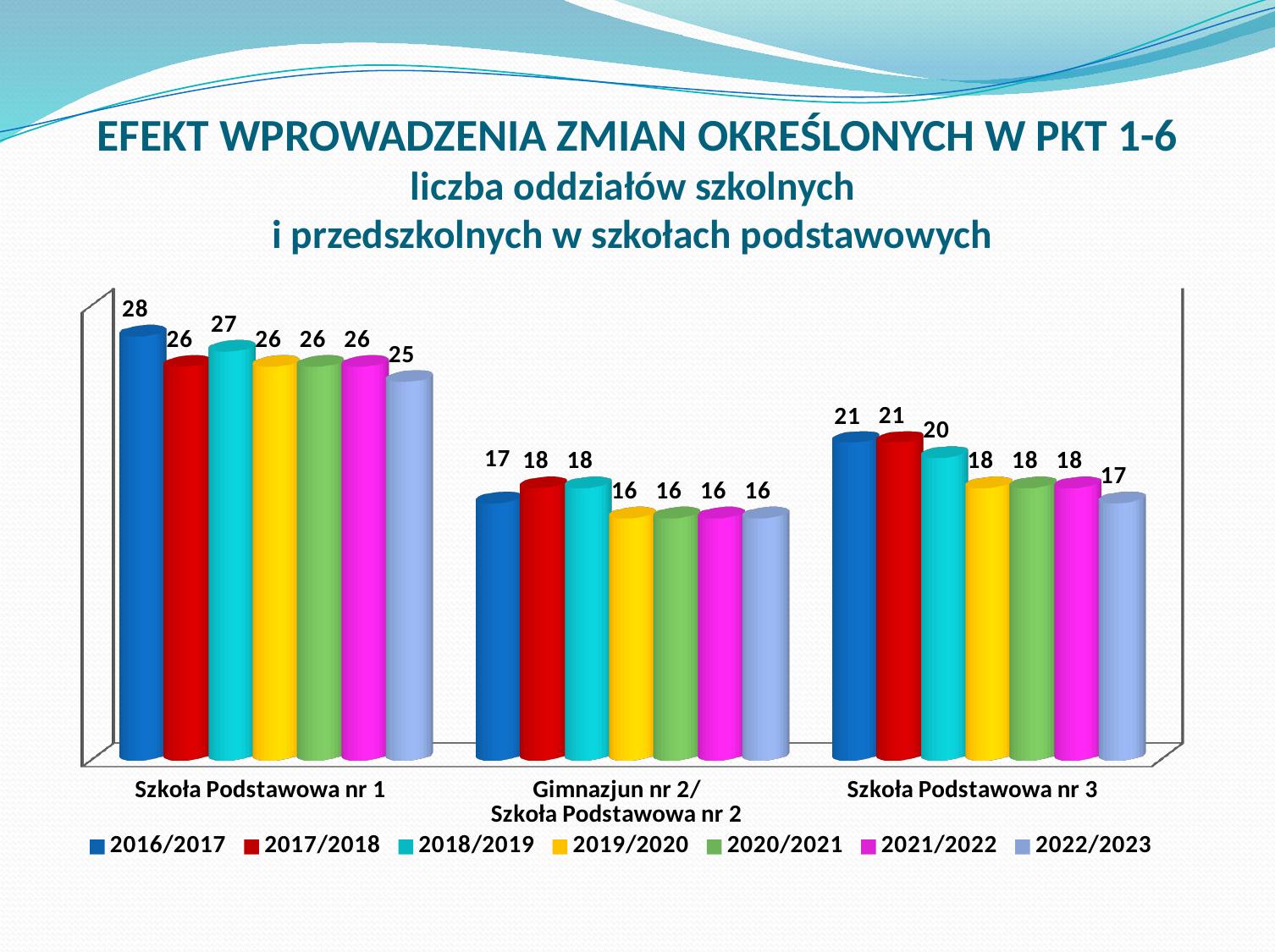
What is the value for Szkoła Podstawowa nr 3 in the 2018/2019 series? 20 What is the value for Szkoła Podstawowa nr 1 in the 2016/2017 series? 28 Which category has the lowest value in the 2022/2023 series? Gimnazjun nr 2/ Szkoła Podstawowa nr 2 What is the value for Szkoła Podstawowa nr 3 in the 2022/2023 series? 17 How many series does the legend list? 7 What is the value for Gimnazjun nr 2/ Szkoła Podstawowa nr 2 in the 2019/2020 series? 16 What kind of chart is shown on the slide? Bar chart Which is larger: the 2017/2018 value for Szkoła Podstawowa nr 1 or the 2017/2018 value for Szkoła Podstawowa nr 3? Szkoła Podstawowa nr 1 What is the difference between the 2016/2017 and 2022/2023 values for Szkoła Podstawowa nr 1? 3 What is the difference between the 2016/2017 and 2022/2023 values for Szkoła Podstawowa nr 3? 4 How many categories are shown on the x axis? 3 Which category has the highest value in the 2016/2017 series? Szkoła Podstawowa nr 1